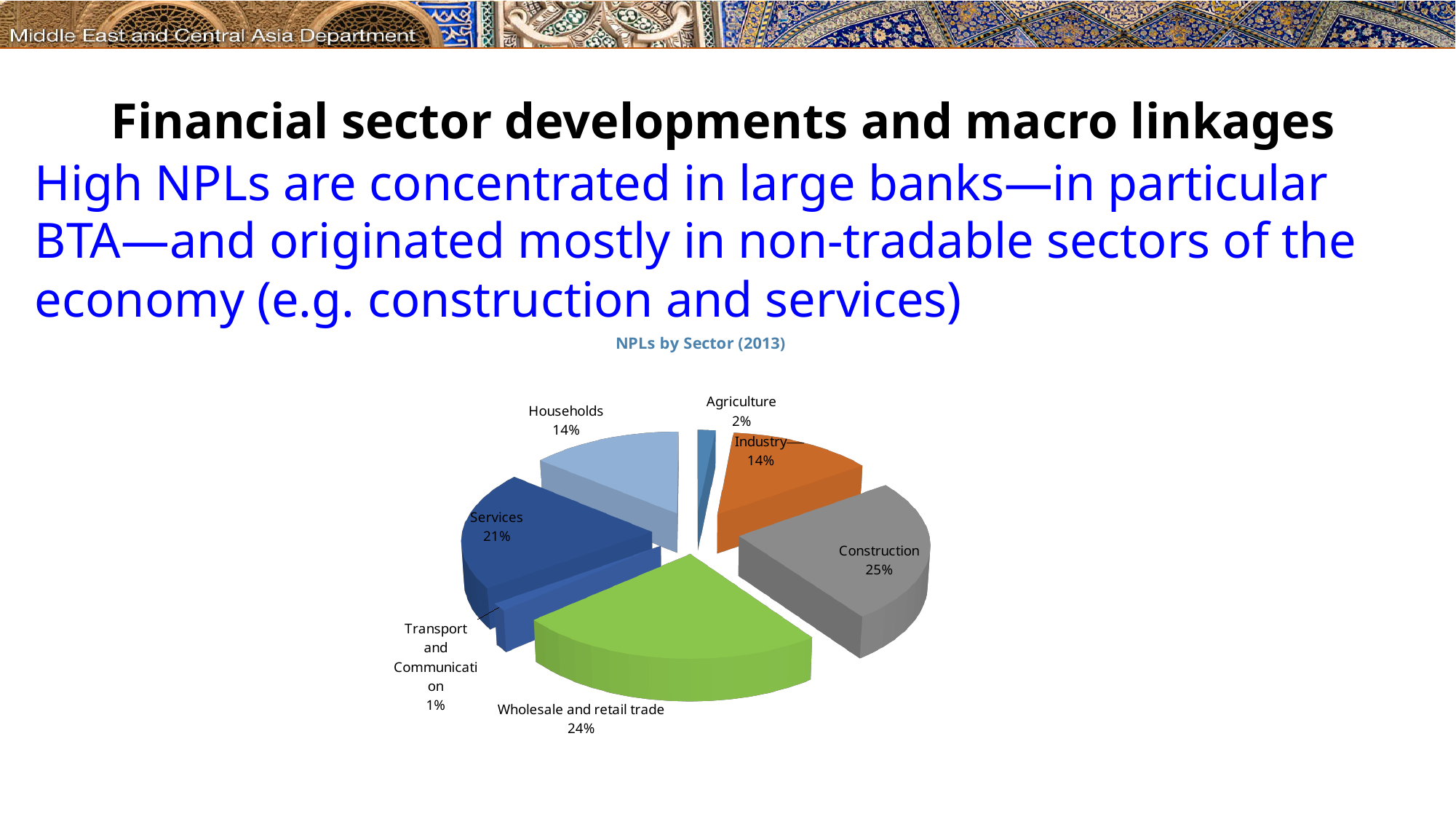
What is the difference in percentage points between the Construction and Services shares? 4 How many sectors are shown in the pie chart? 7 Which has a larger share of NPLs, Households or Agriculture? Households What percentage of NPLs is attributed to Services? 21% Which sector has the largest share of NPLs in the chart? Construction What is the share of Wholesale and retail trade in the pie chart? 24% What type of chart is used to show NPLs by Sector (2013)? Pie chart Which sector has the smallest share of NPLs? Transport and Communication What colour is the Wholesale and retail trade slice? Green What is the title of the chart on the slide? NPLs by Sector (2013) What share of NPLs comes from Agriculture? 2% What share of NPLs does Construction account for in the NPLs by Sector (2013) chart? 25%